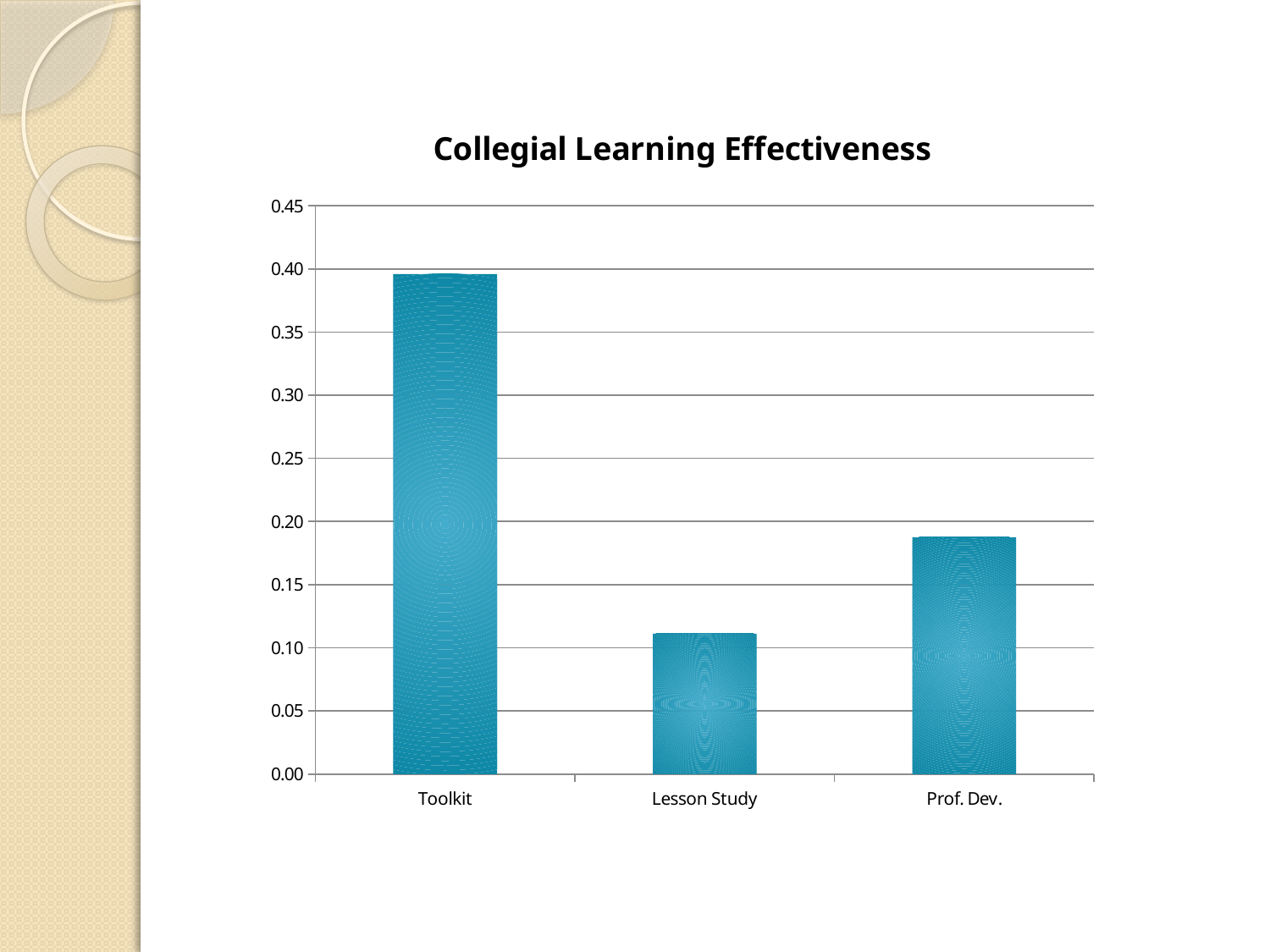
What colour are the bars in the chart? blue Which category has the highest value in the chart? Toolkit What kind of chart is shown on the slide? bar chart Which has the larger value, Lesson Study or Prof. Dev.? Prof. Dev. Which category has the lowest value in the chart? Lesson Study Is the value for Prof. Dev. greater or less than 0.15? greater What is the title of the chart? Collegial Learning Effectiveness Is the value for Toolkit greater or less than 0.35? greater Is the value for Toolkit greater or less than 0.45? less Which has the larger value, Toolkit or Prof. Dev.? Toolkit How many categories are shown on the x axis of the chart? 3